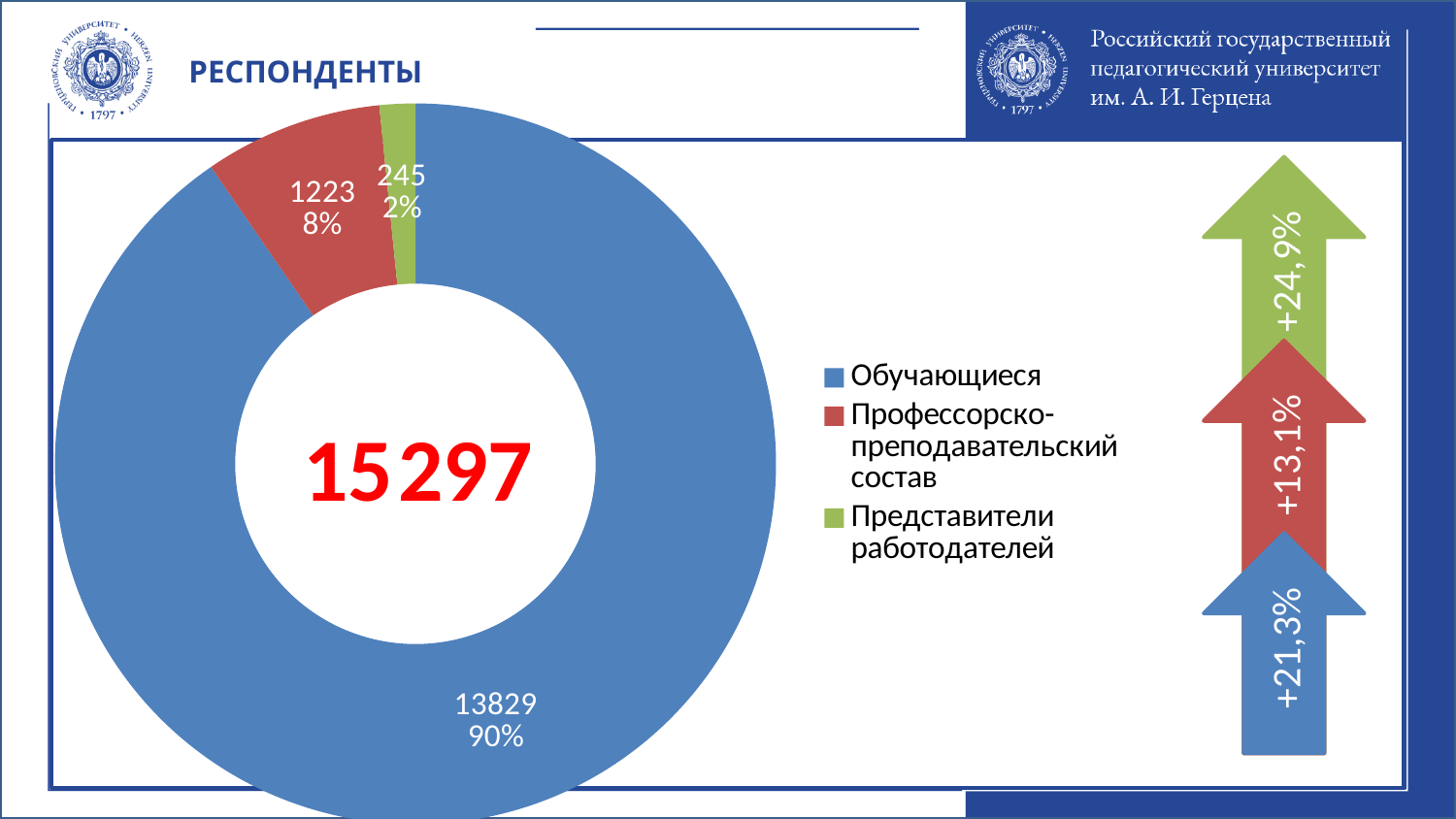
How many categories does the chart show? 3 What is the value for Обучающиеся? 13829 What is the value for Профессорско-преподавательский состав? 1223 What total number is shown in the centre of the chart? 15 297 What share of the chart does Представители работодателей represent? 2% How many entries does the legend list? 3 What is the value for Представители работодателей? 245 What share of the chart does Обучающиеся represent? 90% What kind of chart is shown on the slide? Doughnut (pie) chart Which category has the largest value? Обучающиеся Which category has the smallest value? Представители работодателей What is the difference between the values for Профессорско-преподавательский состав and Представители работодателей? 978